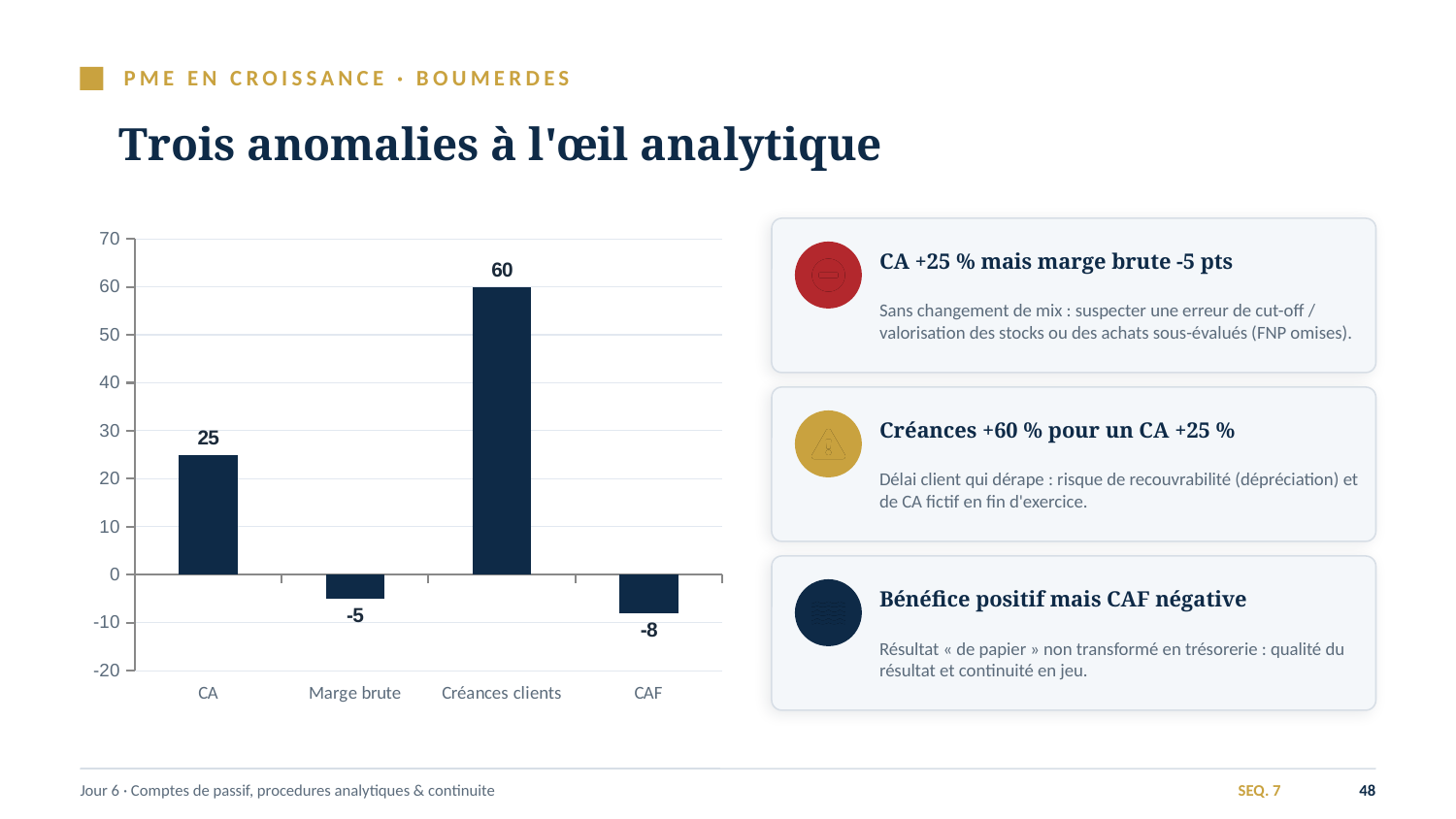
What is the value for CA? 25 What is the value for Créances clients? 60 What is the value for Marge brute? -5 Which category has the lowest value? CAF Is the value for Créances clients greater or less than 50? greater Which is larger, the value for CA or the value for Marge brute? CA Which category has the highest value? Créances clients What kind of chart is shown on the slide? Bar chart How many categories are shown on the x axis? 4 What is the value for CAF? -8 What is the difference between the values for Créances clients and CA? 35 How many bars have negative values? 2